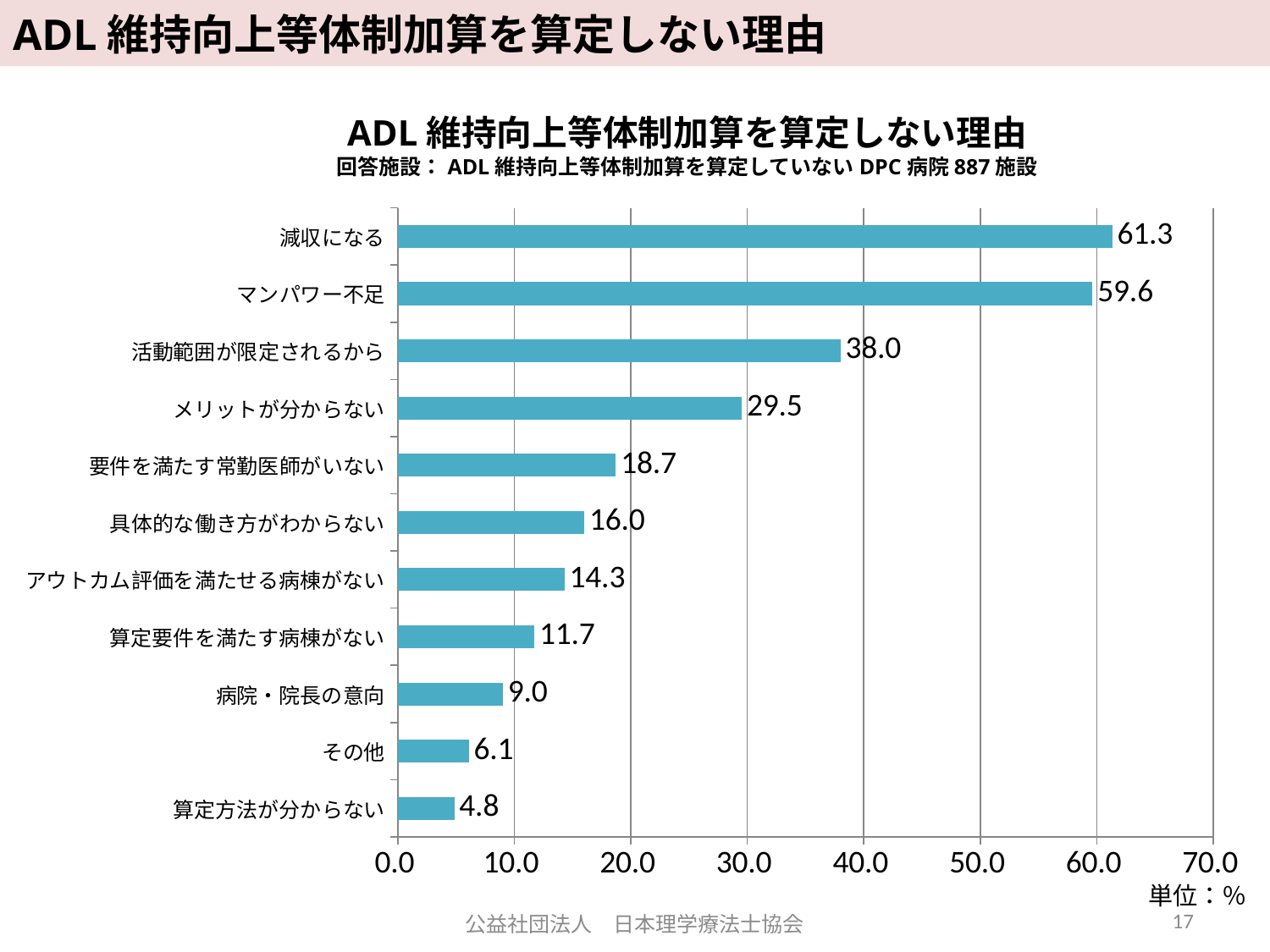
Which category has the highest value? 減収になる Which category has the lowest value? 算定方法が分からない What kind of chart is shown on the slide? Bar chart How many categories are shown in the chart? 11 What is the value for 減収になる? 61.3 What is the value for 要件を満たす常勤医師がいない? 18.7 What is the value for マンパワー不足? 59.6 What is the difference between the values for 減収になる and マンパワー不足? 1.7 What is the difference between the values for 活動範囲が限定されるから and メリットが分からない? 8.5 What unit is indicated for the values in the chart? % What is the value for 算定方法が分からない? 4.8 Which is larger, the value for 具体的な働き方がわからない or the value for アウトカム評価を満たせる病棟がない? 具体的な働き方がわからない